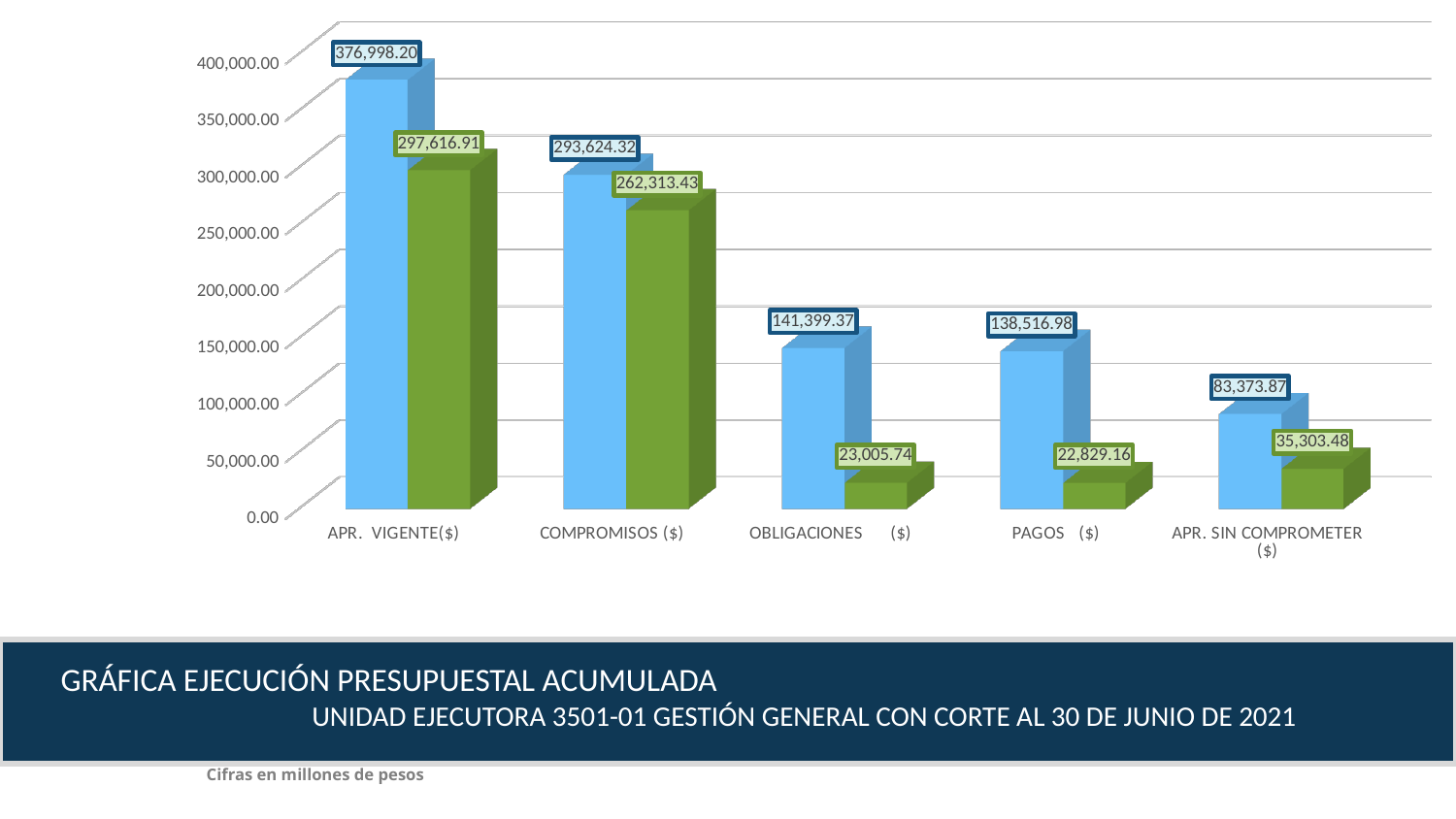
What is the value of the blue bar for APR. VIGENTE($)? 376,998.20 Which category has the lowest green bar? PAGOS ($) What is the difference between the blue and green bars for APR. VIGENTE($)? 79,381.29 What is the value of the green bar for COMPROMISOS ($)? 262,313.43 How many categories are shown on the x axis? 5 What is the title of the chart shown on the slide? GRÁFICA EJECUCIÓN PRESUPUESTAL ACUMULADA UNIDAD EJECUTORA 3501-01 GESTIÓN GENERAL CON CORTE AL 30 DE JUNIO DE 2021 What kind of chart is shown on the slide? Bar chart What is the difference between the blue bars for APR. VIGENTE($) and COMPROMISOS ($)? 83,373.88 What is the value of the blue bar for PAGOS ($)? 138,516.98 Which is larger, the green bar for OBLIGACIONES ($) or the green bar for APR. SIN COMPROMETER ($)? APR. SIN COMPROMETER ($) Which category has the highest blue bar? APR. VIGENTE($) What is the value of the green bar for APR. SIN COMPROMETER ($)? 35,303.48